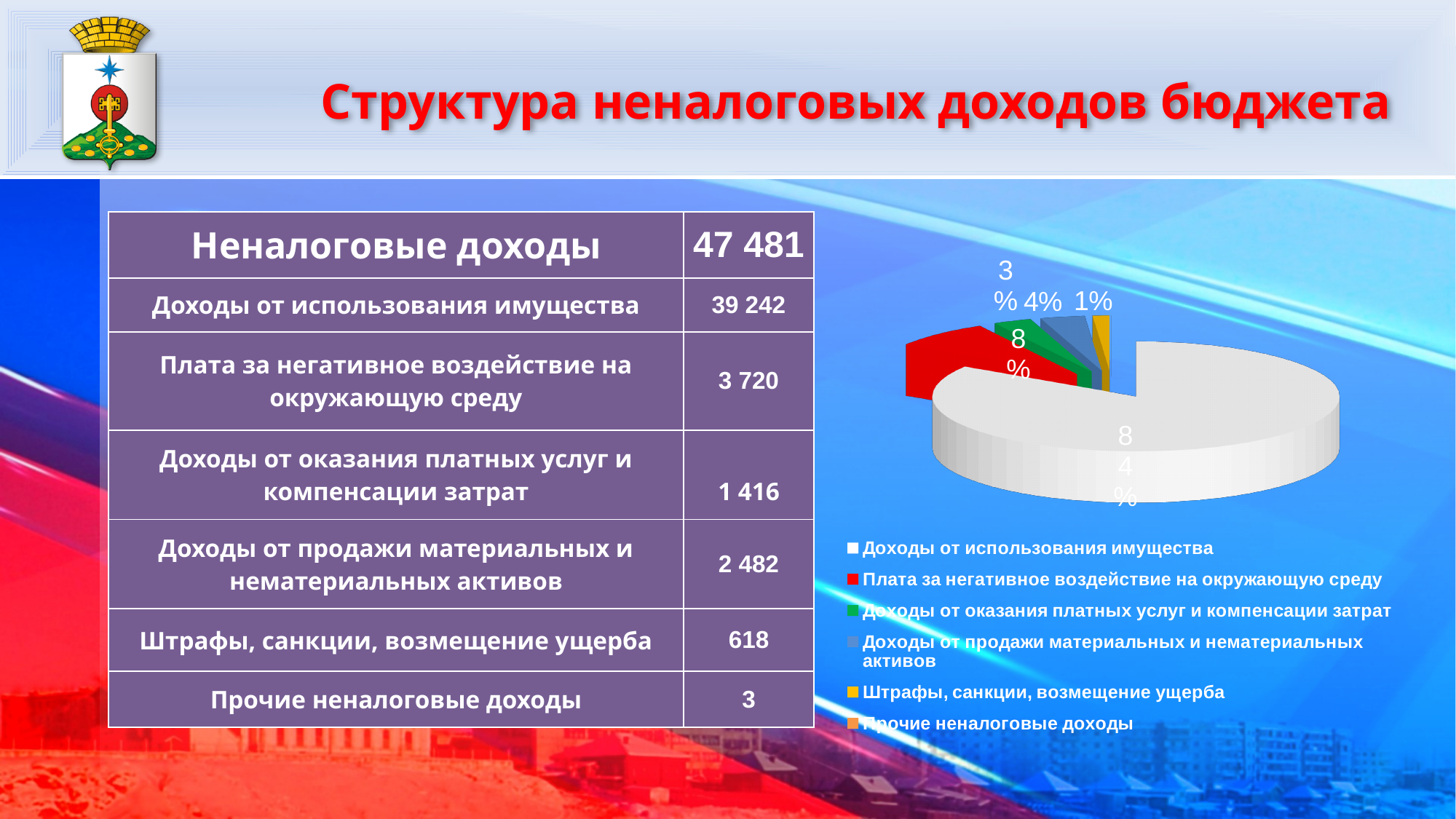
What share of the pie does "Доходы от использования имущества" take? 84% Which category has the largest slice of the pie? Доходы от использования имущества Which labelled slice of the pie is the smallest? Штрафы, санкции, возмещение ущерба How many entries does the chart legend list? 6 What share of the pie does "Плата за негативное воздействие на окружающую среду" take? 8% What is the difference in percentage points between the slices for "Доходы от использования имущества" and "Плата за негативное воздействие на окружающую среду"? 76 What share of the pie does "Доходы от оказания платных услуг и компенсации затрат" take? 3% What kind of chart is shown on the slide? pie chart What share of the pie does "Штрафы, санкции, возмещение ущерба" take? 1% Which slice is larger: "Доходы от продажи материальных и нематериальных активов" or "Доходы от оказания платных услуг и компенсации затрат"? Доходы от продажи материальных и нематериальных активов What colour is the slice for "Плата за негативное воздействие на окружающую среду"? red What share of the pie does "Доходы от продажи материальных и нематериальных активов" take? 4%